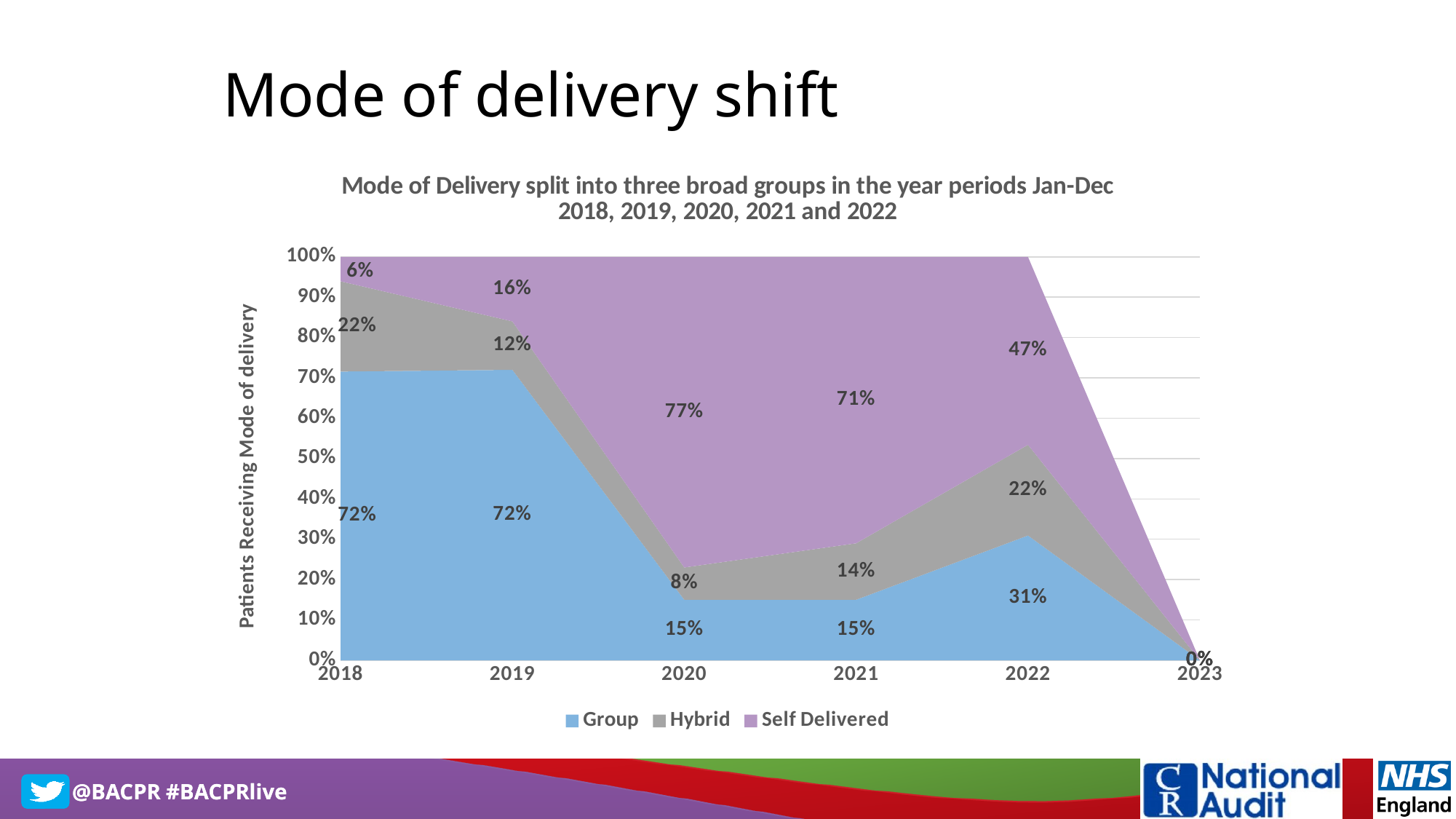
How many series does the legend list? 3 What percentage of patients received Hybrid delivery in 2021? 14% What is the difference between the Group share in 2019 and the Group share in 2020? 57 percentage points Which was larger in 2022, the Hybrid share or the Self Delivered share? Self Delivered What percentage of patients received Group delivery in 2018? 72% What percentage of patients received Group delivery in 2022? 31% Which series is shown in purple in the legend? Self Delivered Does the Group share rise or fall from 2019 to 2020? Fall What percentage of patients received Self Delivered mode in 2020? 77% In which year was the Self Delivered share lowest (excluding 2023)? 2018 In which year was the Self Delivered share highest? 2020 What kind of chart is shown on the slide? Stacked area chart